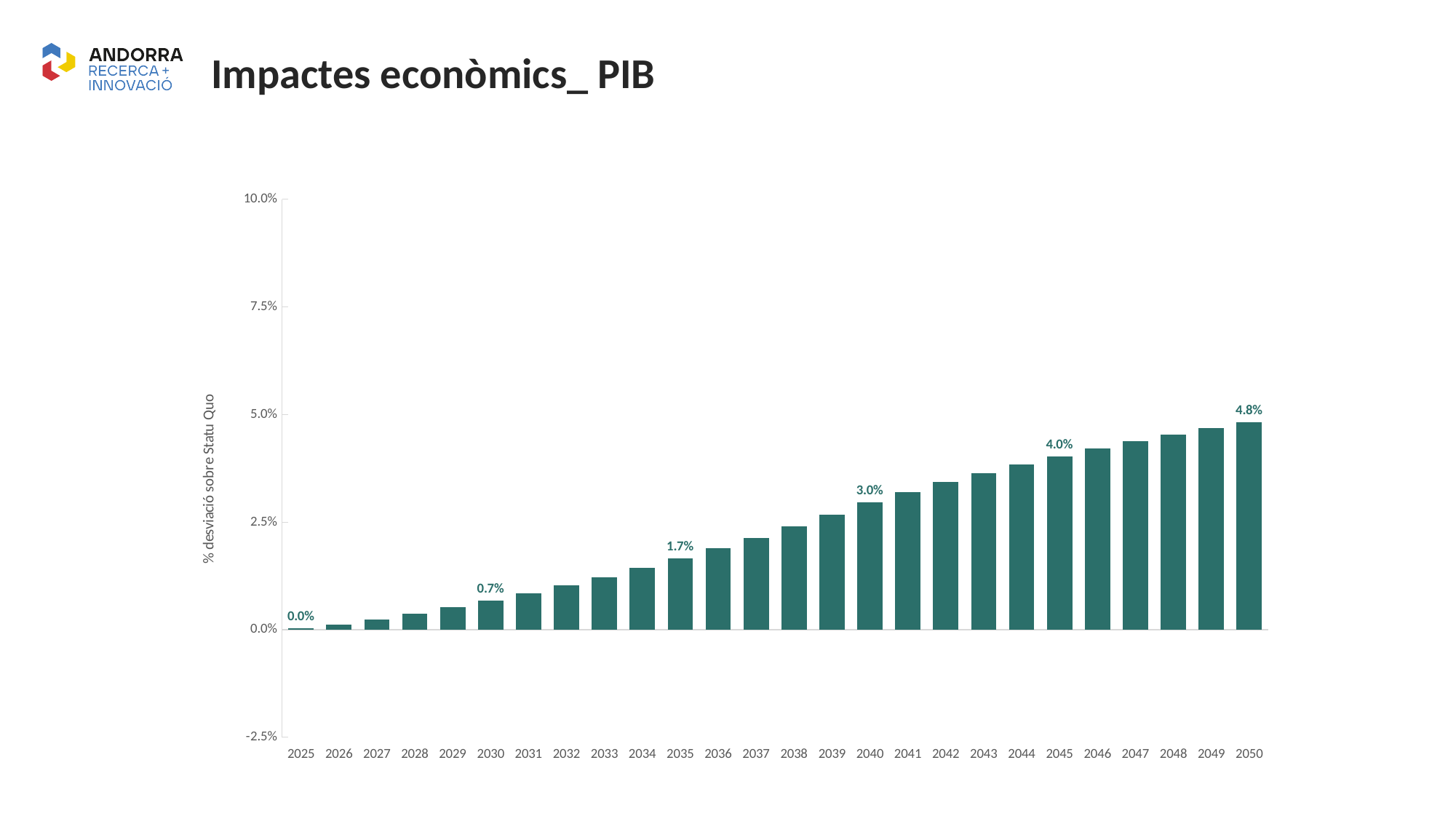
Which year has the lowest value? 2025 What is the value for 2030? 0.7% What is the value for 2040? 3.0% What is the value for 2045? 4.0% What kind of chart is shown on the slide? bar chart How many years are shown on the x axis? 26 Which year has the highest value? 2050 What is the difference between the values for 2050 and 2040? 1.8% What is the value for 2035? 1.7% What is the value for 2050? 4.8% Which is larger, the value for 2035 or the value for 2045? 2045